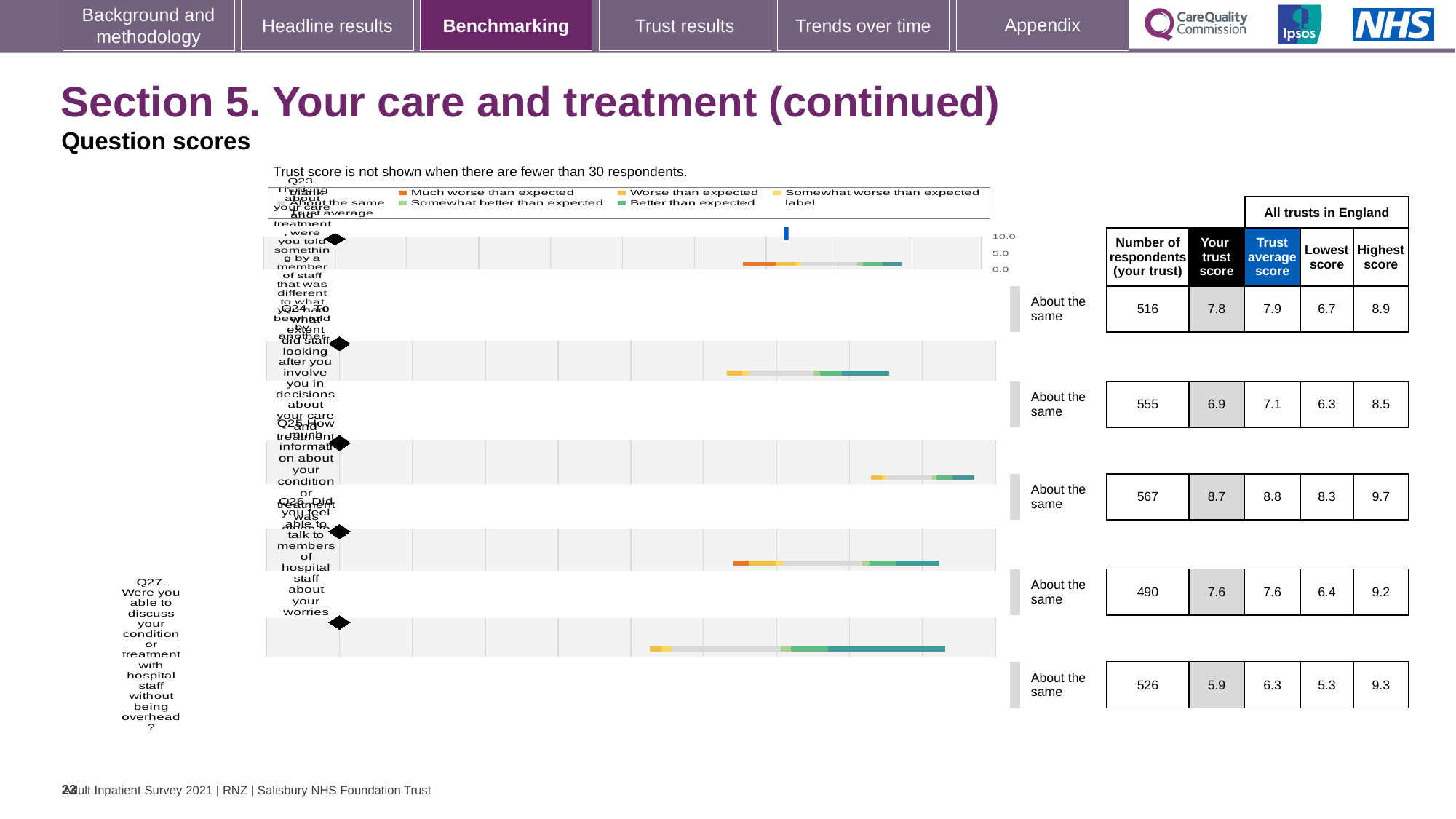
What is the lowest score across all trusts in England for Q24? 6.3 What kind of chart is used to show the question scores? Bar chart For Q27, what is the difference between the trust average score and your trust score? 0.4 Which question has the lowest 'Your trust score' on this slide? Q27 How many respondents (your trust) are shown for Q27? 526 Is your trust score for Q27 greater or less than 5.0? greater What is the highest score across all trusts in England for Q25? 9.7 Which question has the highest 'Your trust score' on this slide? Q25 How many questions are plotted on this slide? 5 What is the 'Your trust score' value for Q27 (able to discuss your condition or treatment without being overheard)? 5.9 For Q23, which is larger: your trust score or the trust average score? Trust average score What benchmark category is shown for every question on this slide? About the same